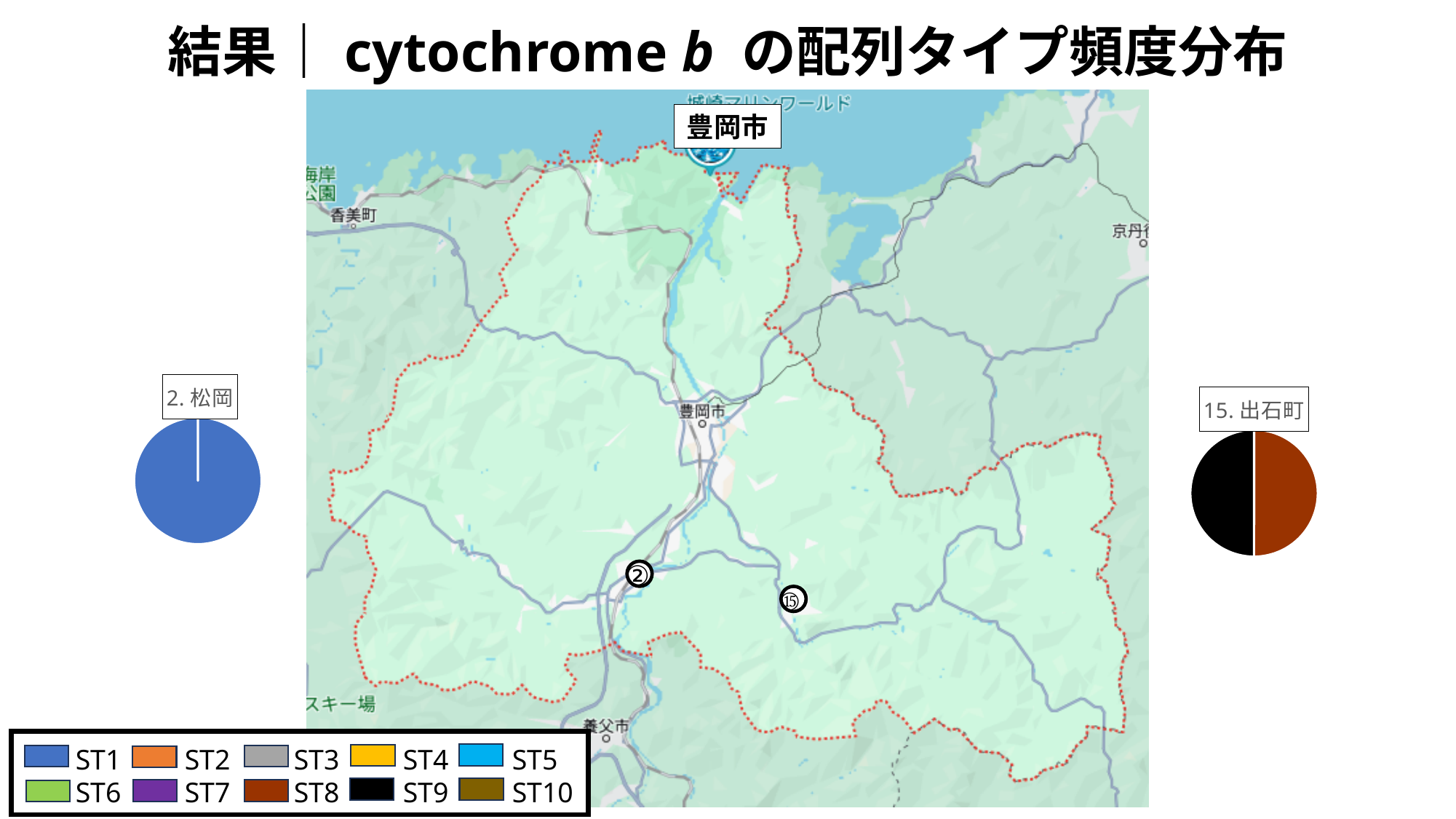
How many sequence types does the legend list? 10 How many sequence types appear in the 2. 松岡 pie chart? 1 How many sequence types appear in the 15. 出石町 pie chart? 2 Which two sequence types appear in the 15. 出石町 pie chart? ST8 and ST9 What share of the 2. 松岡 pie chart is ST1? 100% What colour represents ST8 in the legend? brown What colour represents ST9 in the legend? black In the 2. 松岡 pie chart, which sequence type makes up the whole pie? ST1 What kind of chart is shown for 2. 松岡? pie chart How many pie charts are shown on the slide? 2 What kind of chart is shown for 15. 出石町? pie chart Does ST1 appear in the 15. 出石町 pie chart? No